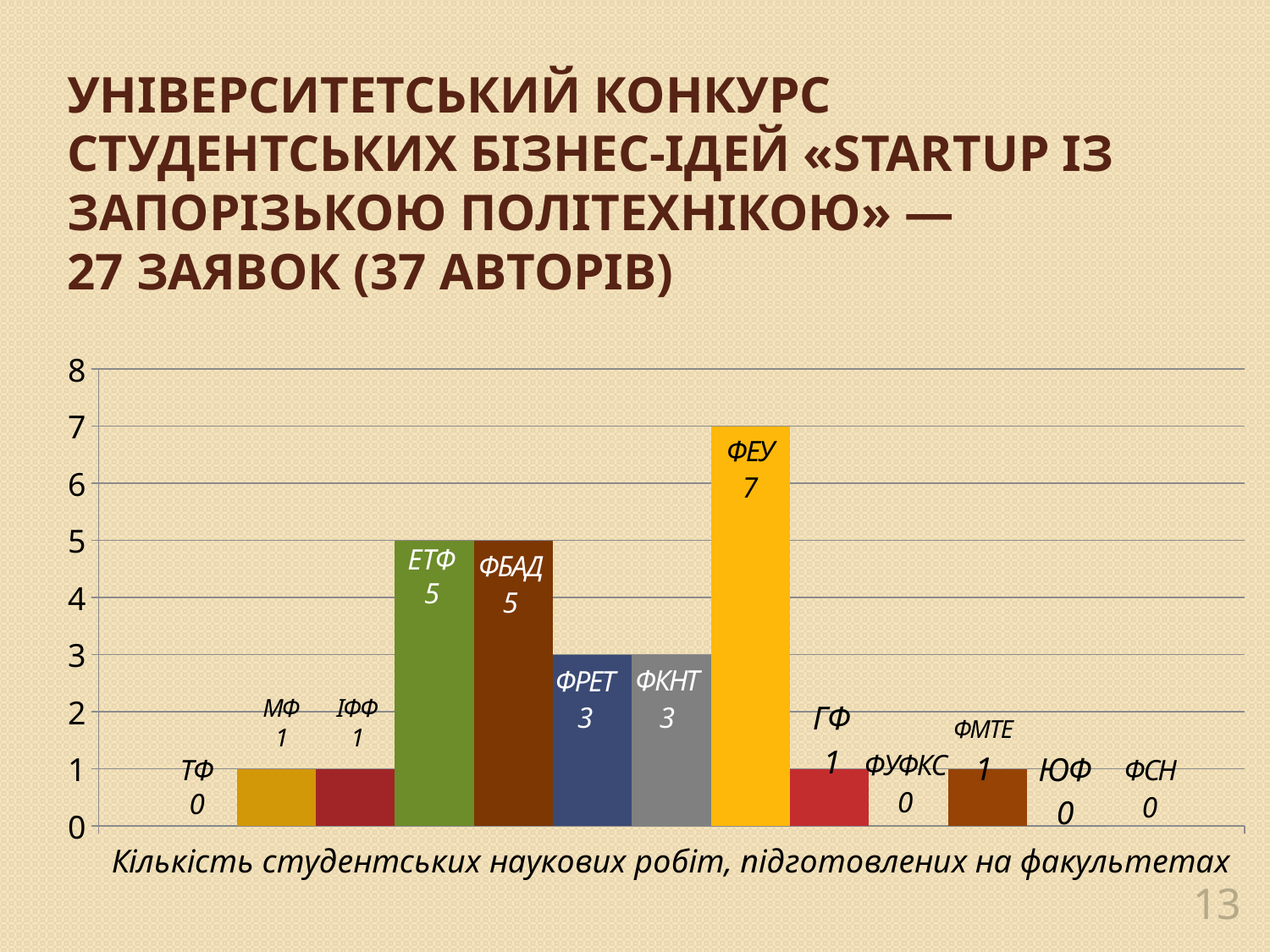
What is the difference between the values for ФЕУ and ФБАД? 2 What is the value for ФМТЕ? 1 What is the value for ФЕУ? 7 How many faculties (categories) are shown in the chart? 13 What is the caption shown below the chart's x axis? Кількість студентських наукових робіт, підготовлених на факультетах Which faculty has the highest number of student works in the chart? ФЕУ Which is larger, the value for ФБАД or the value for ГФ? ФБАД What kind of chart is shown on the slide? bar chart What is the value for ФКНТ? 3 What is the difference between the values for ЕТФ and ФРЕТ? 2 How many faculties have a value of 0 in the chart? 4 What is the value for ЕТФ? 5